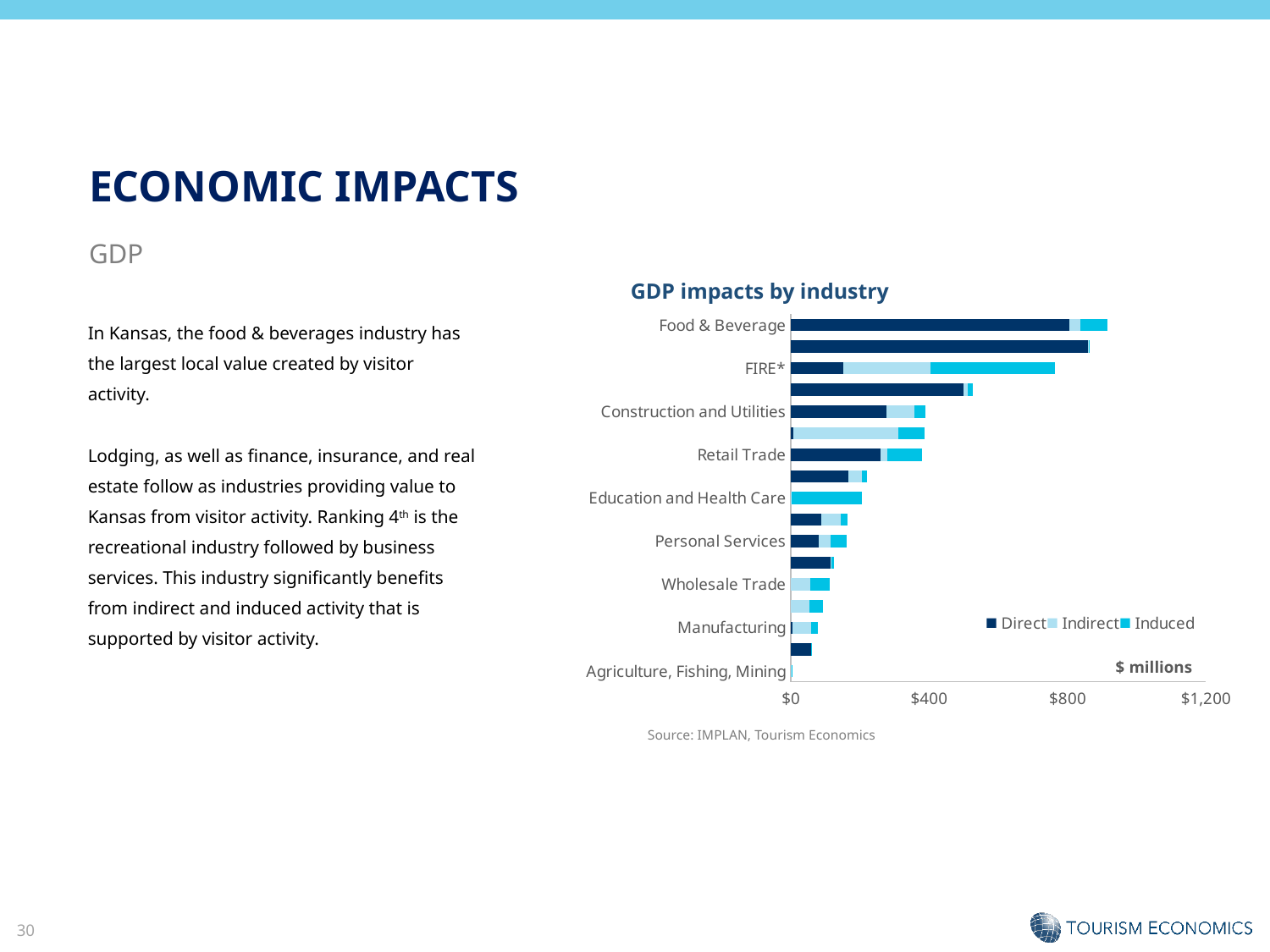
What are the three series named in the chart legend? Direct, Indirect, Induced How many series does the chart legend list? 3 Which has a larger total GDP impact, Food & Beverage or FIRE*? Food & Beverage What kind of chart is shown on the slide? Bar chart Which labeled industry has the smallest total GDP impact in the chart? Agriculture, Fishing, Mining What is the title of the chart? GDP impacts by industry Is the total GDP impact for Food & Beverage greater or less than $800 million? greater Is the total GDP impact for FIRE* greater or less than $400 million? greater Which has a larger total GDP impact, Education and Health Care or Personal Services? Education and Health Care Is the total GDP impact for Education and Health Care greater or less than $400 million? less Which industry has the largest total GDP impact in the chart? Food & Beverage